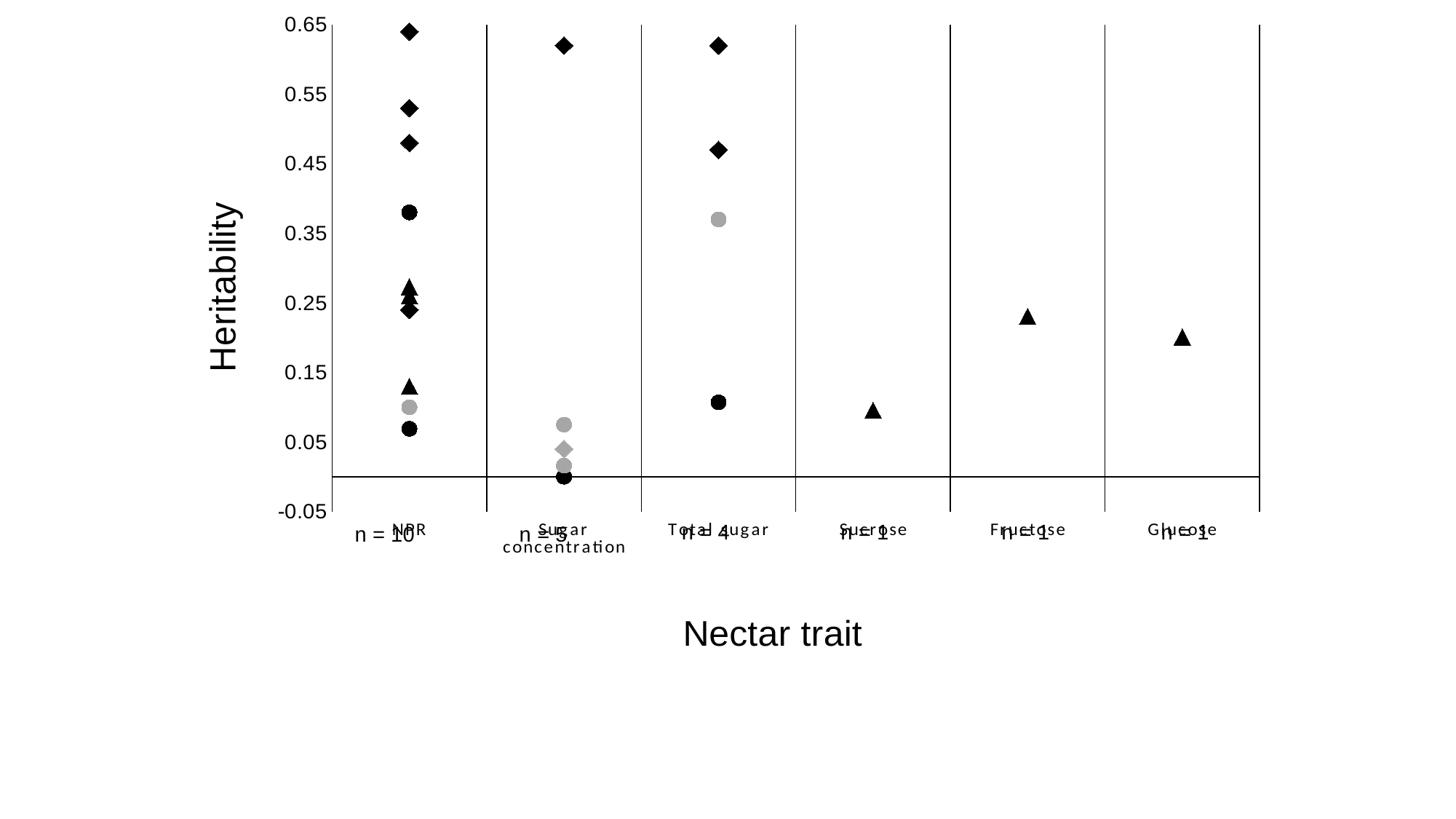
Is the heritability value for Glucose greater or less than 0.25? less Which has the higher heritability value, Sucrose or Fructose? Fructose Is the heritability value for Fructose greater or less than 0.15? greater What is the title of the y axis? Heritability Is the lowest heritability point for Total sugar greater or less than 0.15? less Which nectar trait has the most data points plotted? NPR How many data points (n) are plotted for Sugar concentration? 5 How many nectar trait categories are shown along the x axis? 6 What is the title of the x axis? Nectar trait What kind of chart is shown on the slide? scatter chart